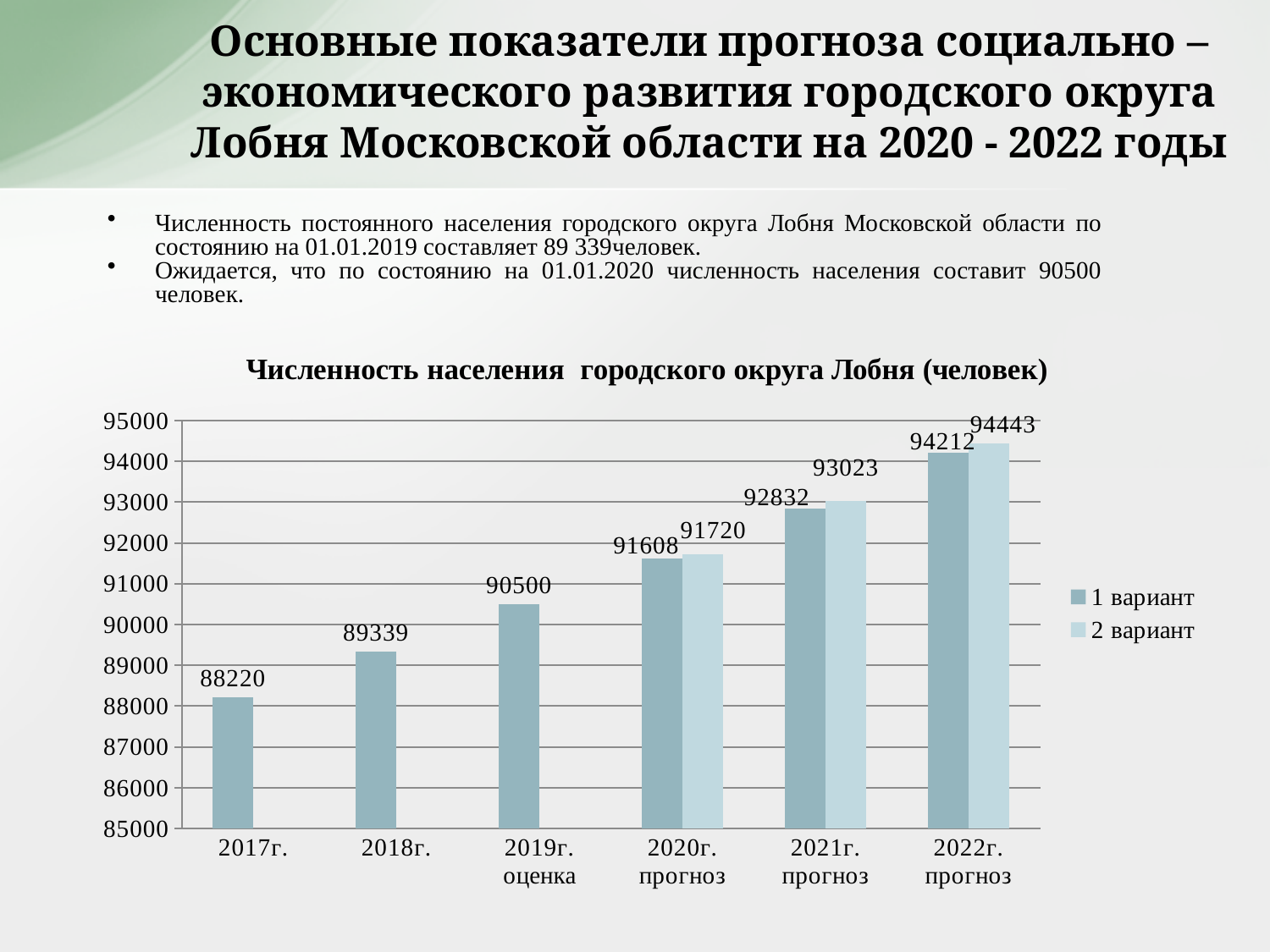
Какое значение по 1 варианту показано для 2021г. прогноз? 92832 Какое значение показано для 2017г. на диаграмме «Численность населения городского округа Лобня (человек)»? 88220 На сколько значение 2 варианта для 2020г. прогноз больше значения 1 варианта? 112 Какое значение по 2 варианту показано для 2022г. прогноз? 94443 Сколько категорий (лет) показано по оси X диаграммы? 6 Для какого года показано наименьшее значение численности населения? 2017г. Какого типа эта диаграмма? Столбчатая (bar chart) Какой столбец на диаграмме самый высокий? 2 вариант, 2022г. прогноз Какое значение показано для 2019г. оценка? 90500 Что больше: значение 1 варианта для 2022г. прогноз или значение 2 варианта для 2021г. прогноз? 1 вариант для 2022г. прогноз На сколько значение 2018г. больше значения 2017г.? 1119 Сколько рядов данных перечислено в легенде диаграммы? 2